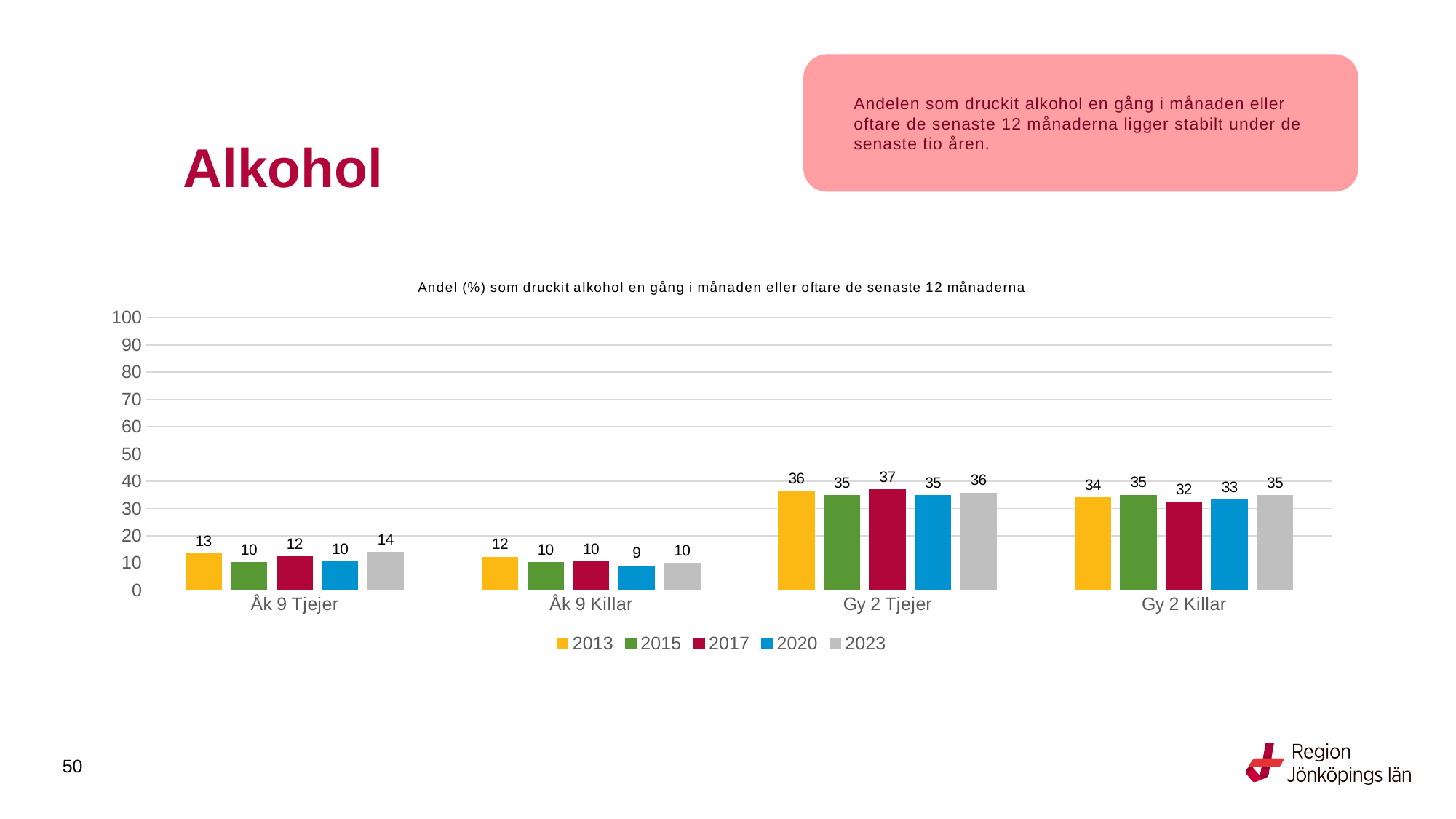
Which is larger: the 2013 value for Åk 9 Tjejer or the 2013 value for Åk 9 Killar? Åk 9 Tjejer What is the value for Åk 9 Killar in 2020? 9 What kind of chart is shown on the slide? Bar chart What is the value for Gy 2 Killar in 2013? 34 Which category has the highest value in 2023? Gy 2 Tjejer Which category has the lowest value in 2020? Åk 9 Killar What is the difference between the 2017 values for Gy 2 Tjejer and Gy 2 Killar? 5 What is the value for Åk 9 Tjejer in 2023? 14 How many categories are shown on the x axis? 4 What is the value for Gy 2 Tjejer in 2017? 37 How many series does the legend list? 5 Which colour represents the 2020 series in the legend? Blue